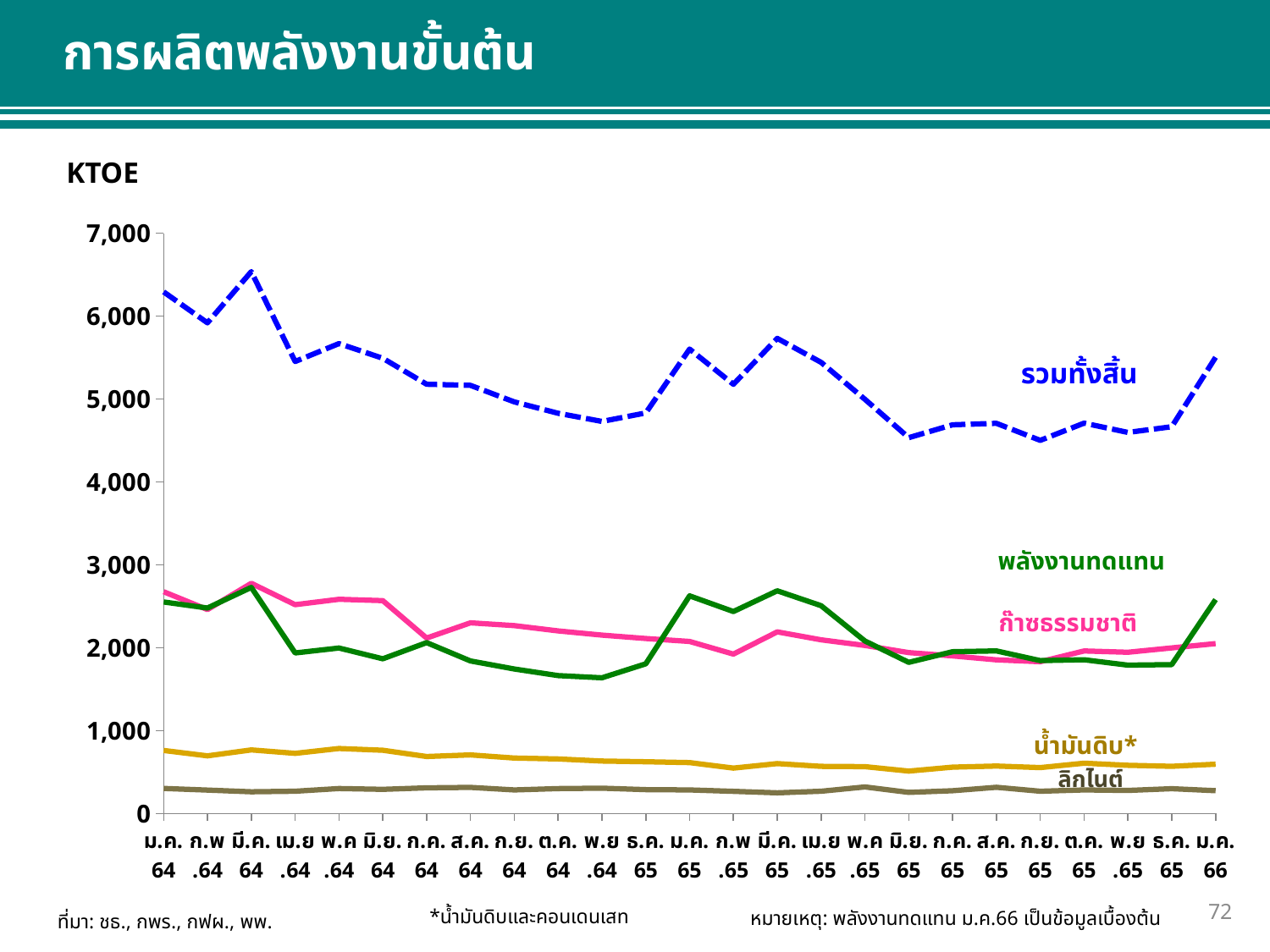
Is the value for รวมทั้งสิ้น in ธ.ค. 65 greater or less than 5,000? less Is the value for พลังงานทดแทน in ม.ค. 66 greater or less than 2,000? greater Is the value for น้ำมันดิบ* in ม.ค. 64 greater or less than 1,000? less Does the รวมทั้งสิ้น line generally rise or fall from ม.ค. 64 to ธ.ค. 65? fall How many monthly points are plotted along the x axis? 25 In ม.ค. 66, which is larger: พลังงานทดแทน or ก๊าซธรรมชาติ? พลังงานทดแทน Which series is drawn as a dashed blue line? รวมทั้งสิ้น How many data series are labelled on the chart? 5 What unit is shown for the y axis? KTOE What kind of chart is shown on the slide? line chart Which series has the lowest values across the whole period? ลิกไนต์